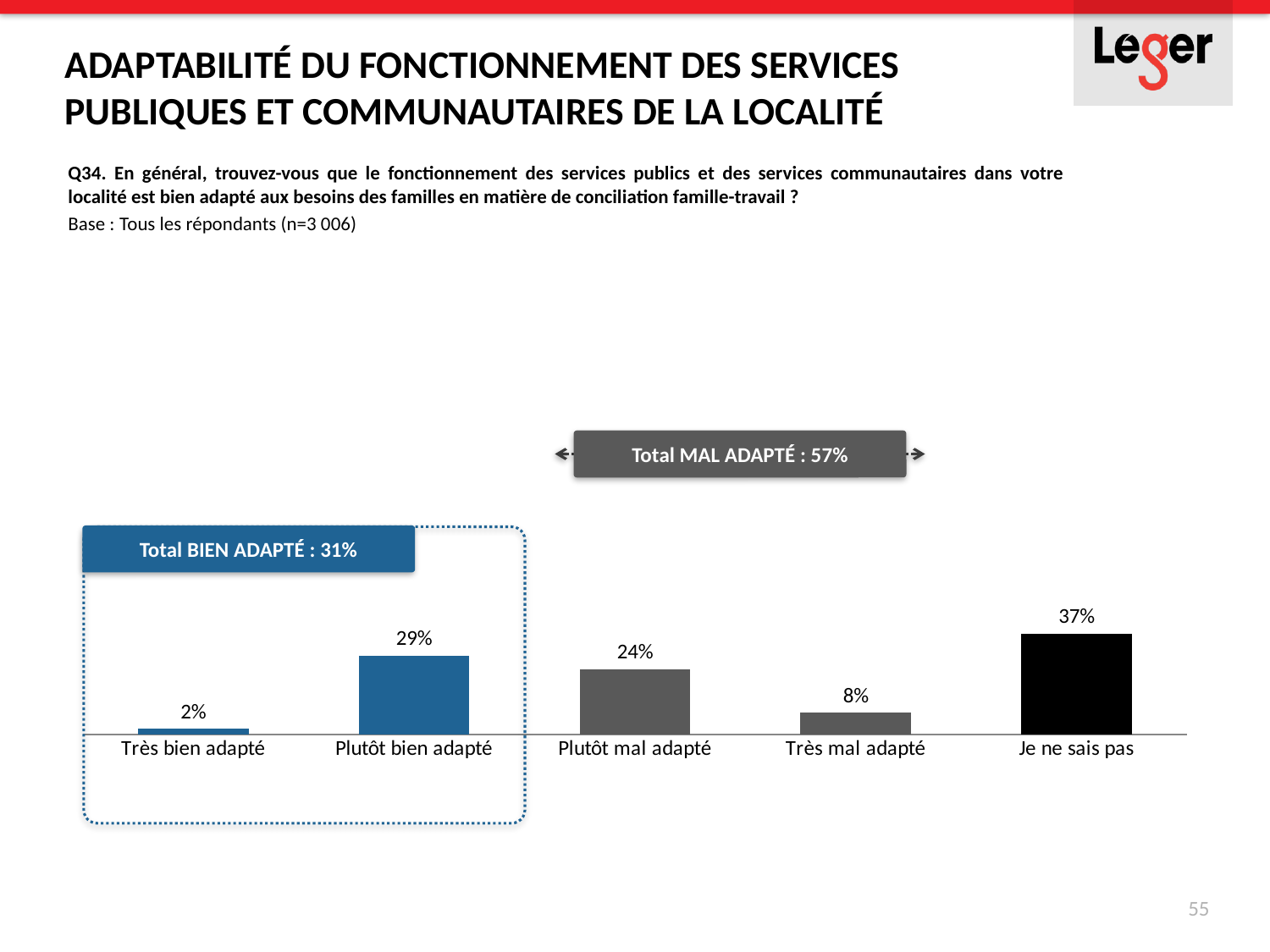
Which category has the lowest value? Très bien adapté Which category has the highest value? Je ne sais pas What total is shown in the box labelled "Total BIEN ADAPTÉ"? 31% What total is shown in the box labelled "Total MAL ADAPTÉ"? 57% What is the value for "Plutôt bien adapté"? 29% What is the value for "Plutôt mal adapté"? 24% What kind of chart is shown on the slide? Bar chart What is the value for "Je ne sais pas"? 37% What is the difference between "Plutôt bien adapté" and "Plutôt mal adapté"? 5% How many categories are shown in the chart? 5 Which is larger, "Très mal adapté" or "Très bien adapté"? Très mal adapté What is the value for "Très mal adapté"? 8%